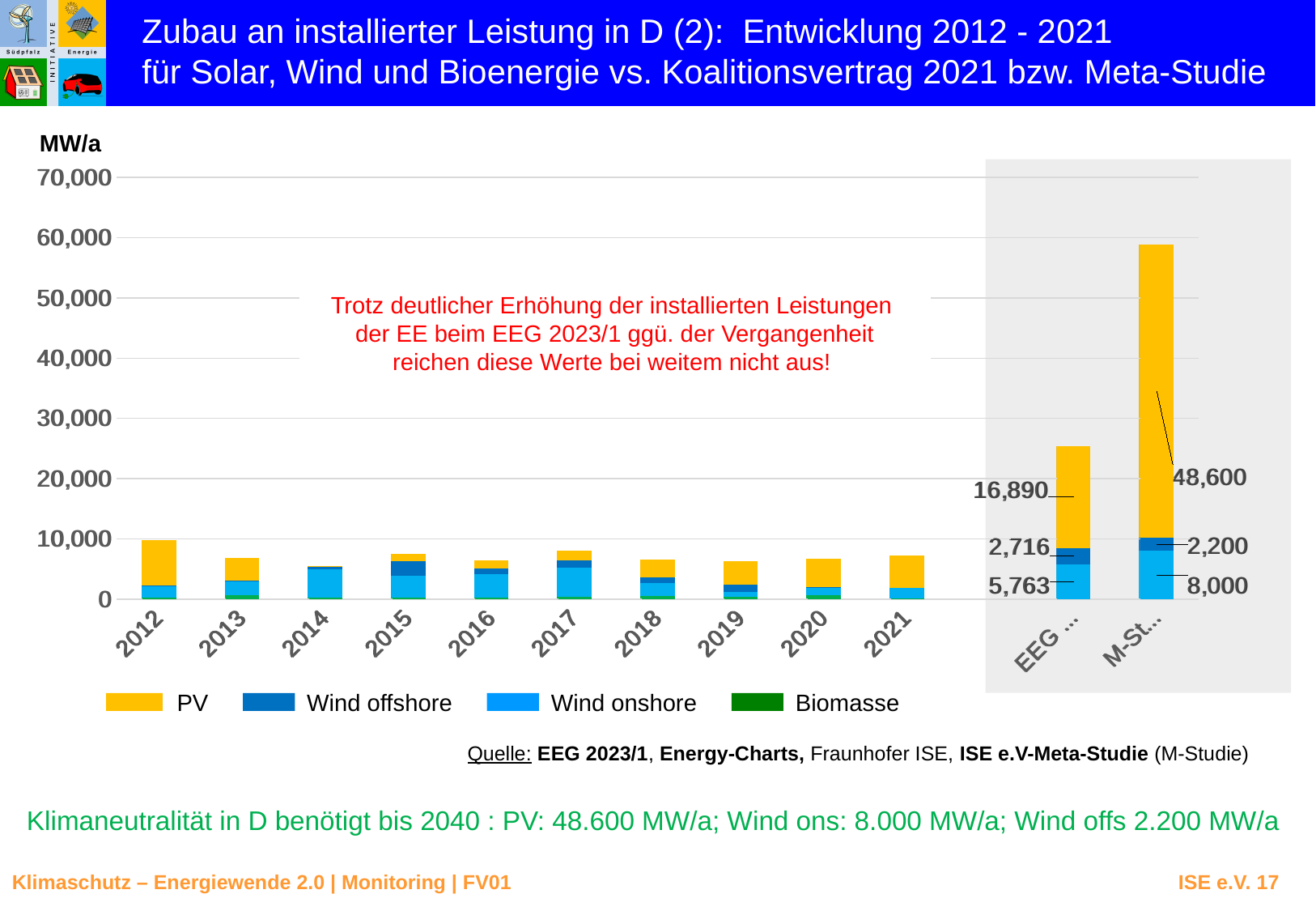
Is the total value of the 2021 bar greater or less than 10,000? less What type of chart is shown on the slide? stacked bar chart Which bar is the highest overall in the chart? M-St... (Meta-Studie) What is the PV value labelled on the EEG bar? 16,890 What is the PV value labelled on the M-St... (Meta-Studie) bar? 48,600 How many series does the legend list? 4 What is the difference between the PV value of the M-St... bar (48,600) and the PV value of the EEG bar (16,890)? 31,710 What is the Wind offshore value labelled on the M-St... (Meta-Studie) bar? 2,200 What is the Wind onshore value labelled on the EEG bar? 5,763 How many bars (categories) are plotted along the x axis? 12 What unit is shown at the top of the y axis? MW/a What is the difference between the Wind onshore value of the M-St... bar (8,000) and that of the EEG bar (5,763)? 2,237